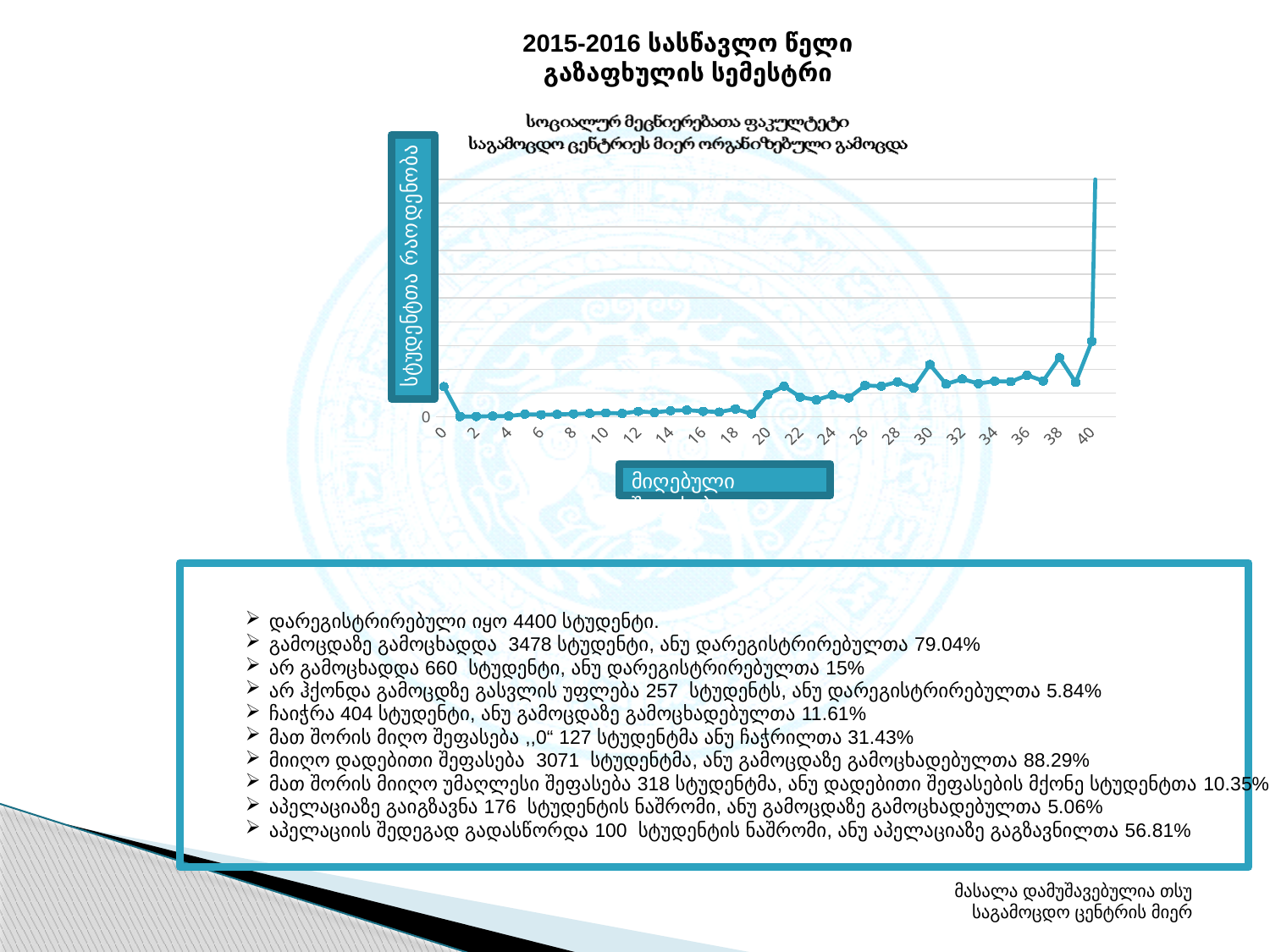
What kind of chart is shown on the slide? line chart Overall, do the values rise or fall as the x-axis value increases from 0 to 40? rise Which has the larger value, x = 30 or x = 28? 30 What is the highest x-axis tick label shown on the chart? 40 Which has the larger value, x = 40 or x = 20? 40 Which has the larger value, x = 21 or x = 23? 21 How many tick labels are shown along the x axis? 21 What is the lowest x-axis tick label shown on the chart? 0